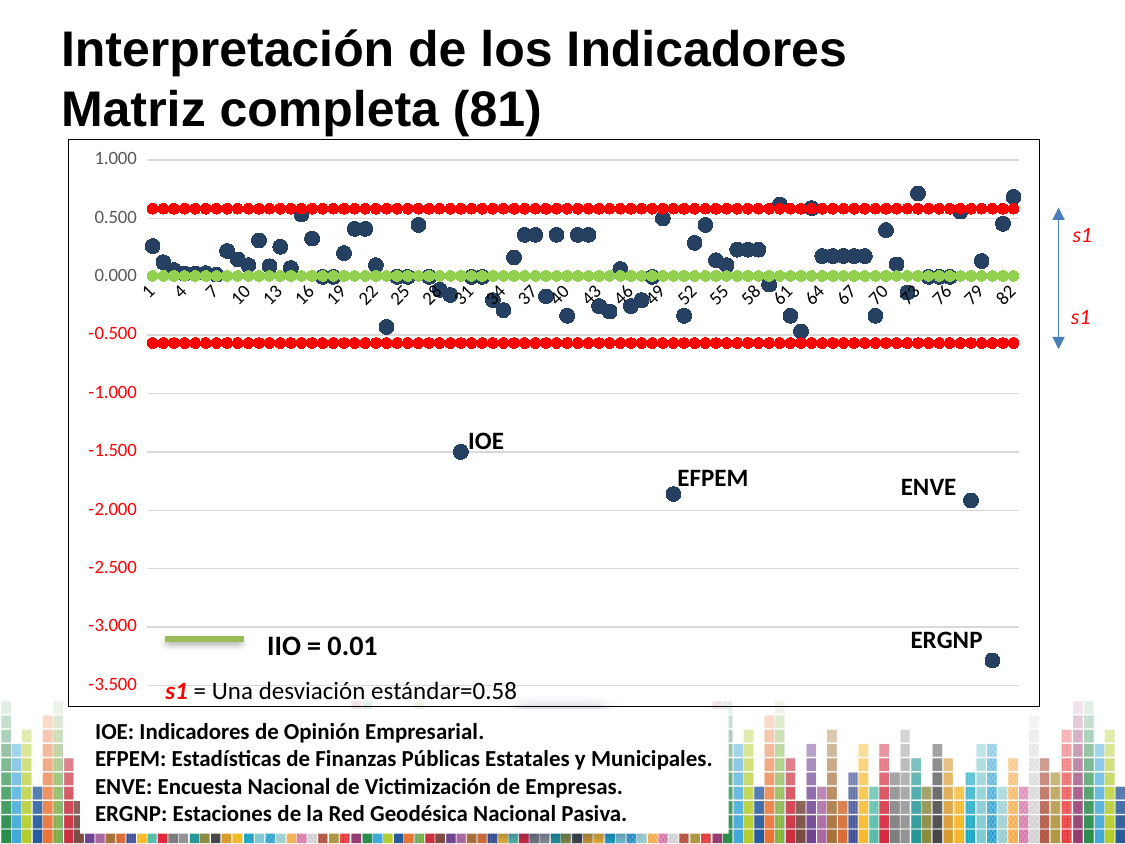
What kind of chart is shown on the slide? scatter chart What colour is the line representing IIO on the chart? green Which has the higher value, IOE or ERGNP? IOE Is the value for ENVE greater or less than -1.500? less What is the value of IIO shown on the chart? 0.01 Which has the higher value, IOE or EFPEM? IOE What is the value of one standard deviation (s1) stated on the chart? 0.58 Is the value for EFPEM greater or less than -1.500? less Is the value for ERGNP greater or less than -3.000? less How many indicators are labelled by name as outliers on the chart? 4 Which labelled indicator has the lowest value on the chart? ERGNP